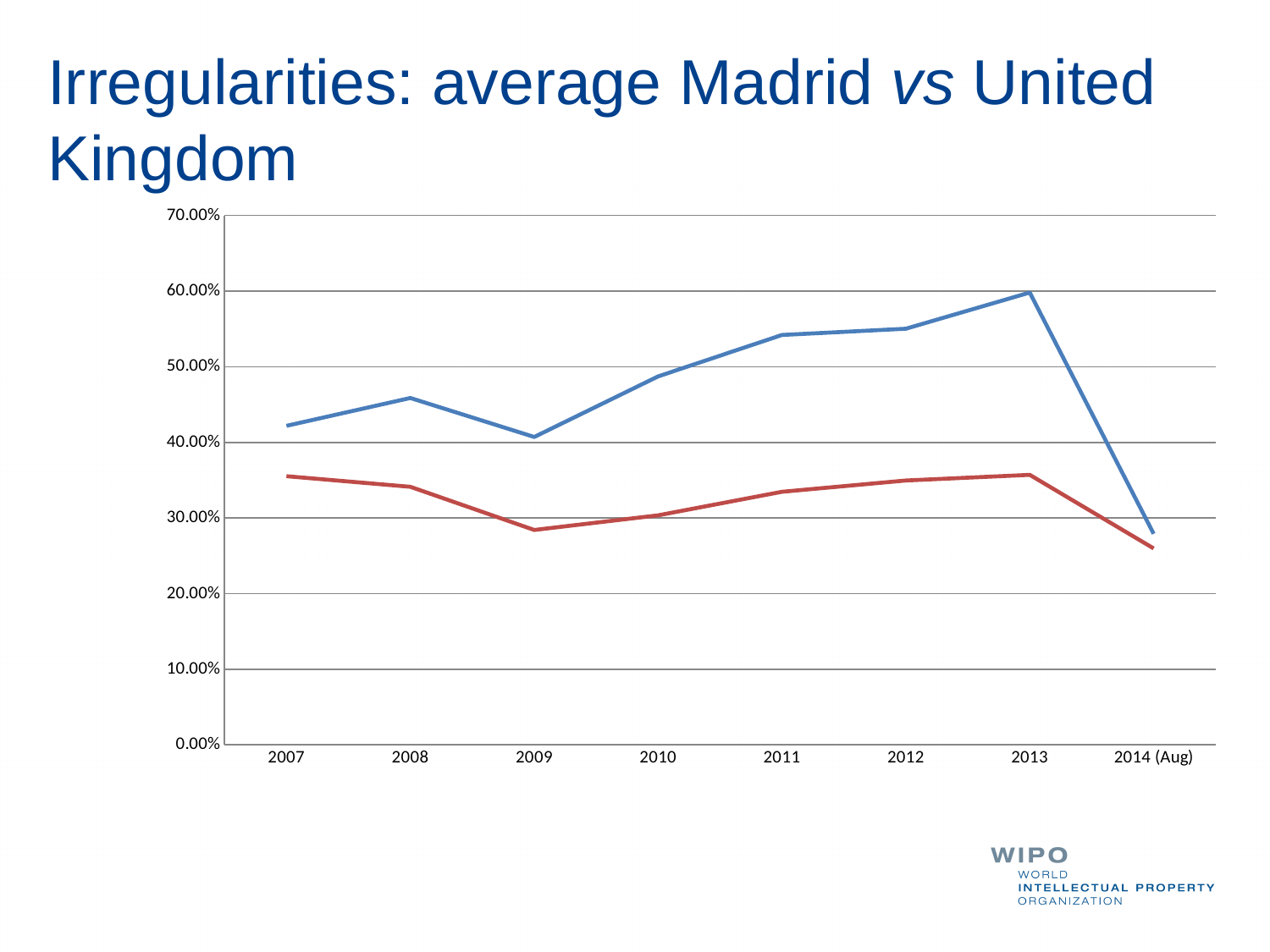
How many points are shown along the x axis of the chart? 8 Is the value of the blue line in 2011 greater or less than 50.00%? greater Does the blue line rise or fall between 2009 and 2013? rise Is the value of the red line in 2007 greater or less than 30.00%? greater Is the value of the red line in 2013 greater or less than 40.00%? less What kind of chart is shown on the slide? line chart At which x-axis point does the blue line reach its lowest value? 2014 (Aug) In which year does the blue line reach its highest value? 2013 How many lines are plotted on the chart? 2 In 2013, which line has the higher value, the blue line or the red line? the blue line Does the blue line rise or fall between 2013 and 2014 (Aug)? fall